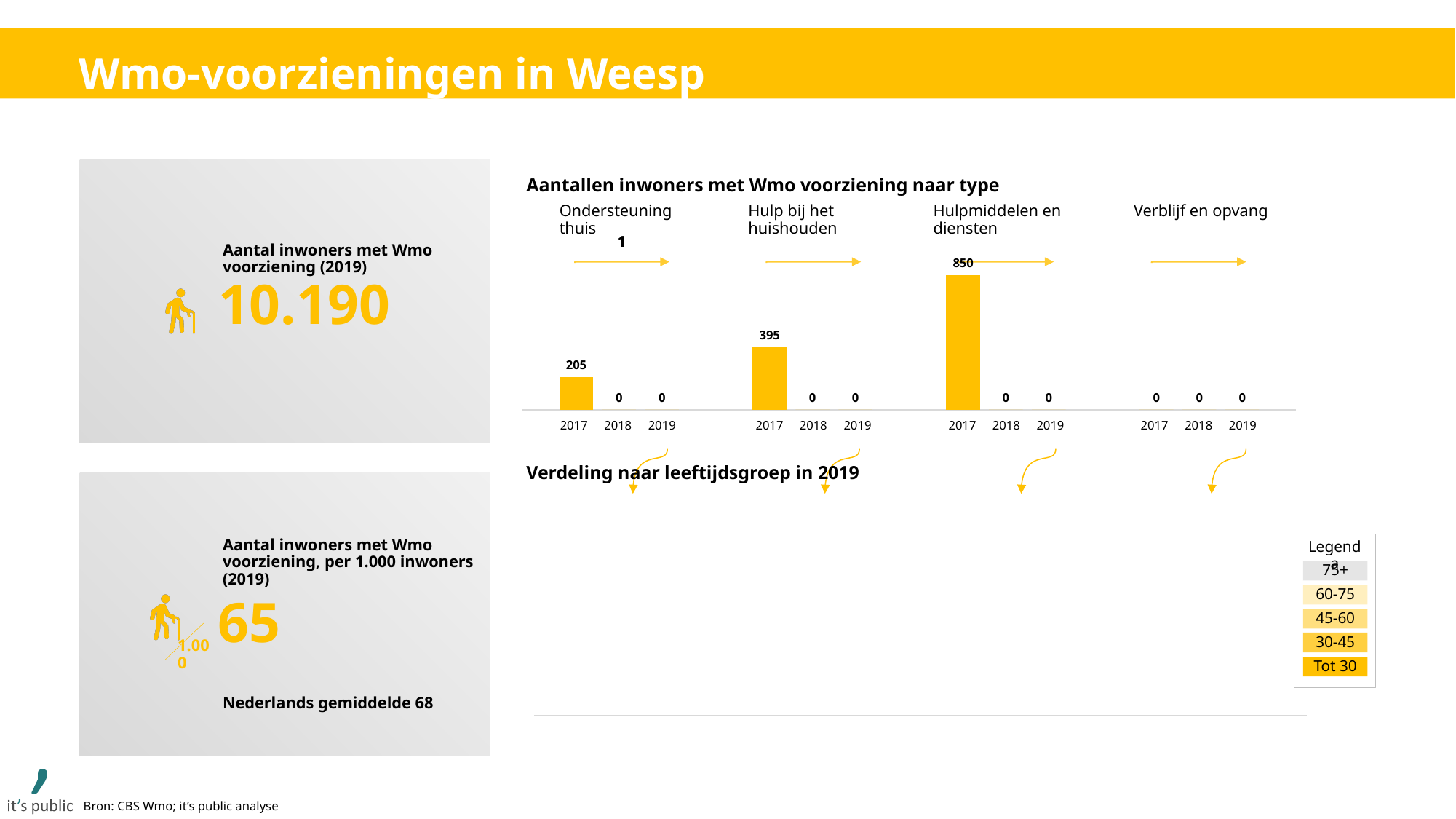
In the chart 'Aantallen inwoners met Wmo voorziening naar type', what is the value for Ondersteuning thuis in 2017? 205 In the chart 'Aantallen inwoners met Wmo voorziening naar type', which is larger in 2017: Ondersteuning thuis or Hulp bij het huishouden? Hulp bij het huishouden In the chart 'Aantallen inwoners met Wmo voorziening naar type', what is the difference between the 2017 values for Hulpmiddelen en diensten and Hulp bij het huishouden? 455 In the chart 'Aantallen inwoners met Wmo voorziening naar type', what is the difference between the 2017 values for Hulp bij het huishouden and Ondersteuning thuis? 190 What kind of chart is 'Aantallen inwoners met Wmo voorziening naar type'? bar chart In the chart 'Aantallen inwoners met Wmo voorziening naar type', which type has the highest value in 2017? Hulpmiddelen en diensten In the chart 'Aantallen inwoners met Wmo voorziening naar type', which type has the lowest value in 2017? Verblijf en opvang In the chart 'Aantallen inwoners met Wmo voorziening naar type', how many types of Wmo voorziening are shown? 4 In the chart 'Aantallen inwoners met Wmo voorziening naar type', what is the value for Verblijf en opvang in 2017? 0 In the chart 'Aantallen inwoners met Wmo voorziening naar type', what is the value for Hulp bij het huishouden in 2017? 395 In the chart 'Aantallen inwoners met Wmo voorziening naar type', what is the value for Hulpmiddelen en diensten in 2017? 850 How many age groups does the legend next to 'Verdeling naar leeftijdsgroep in 2019' list? 5